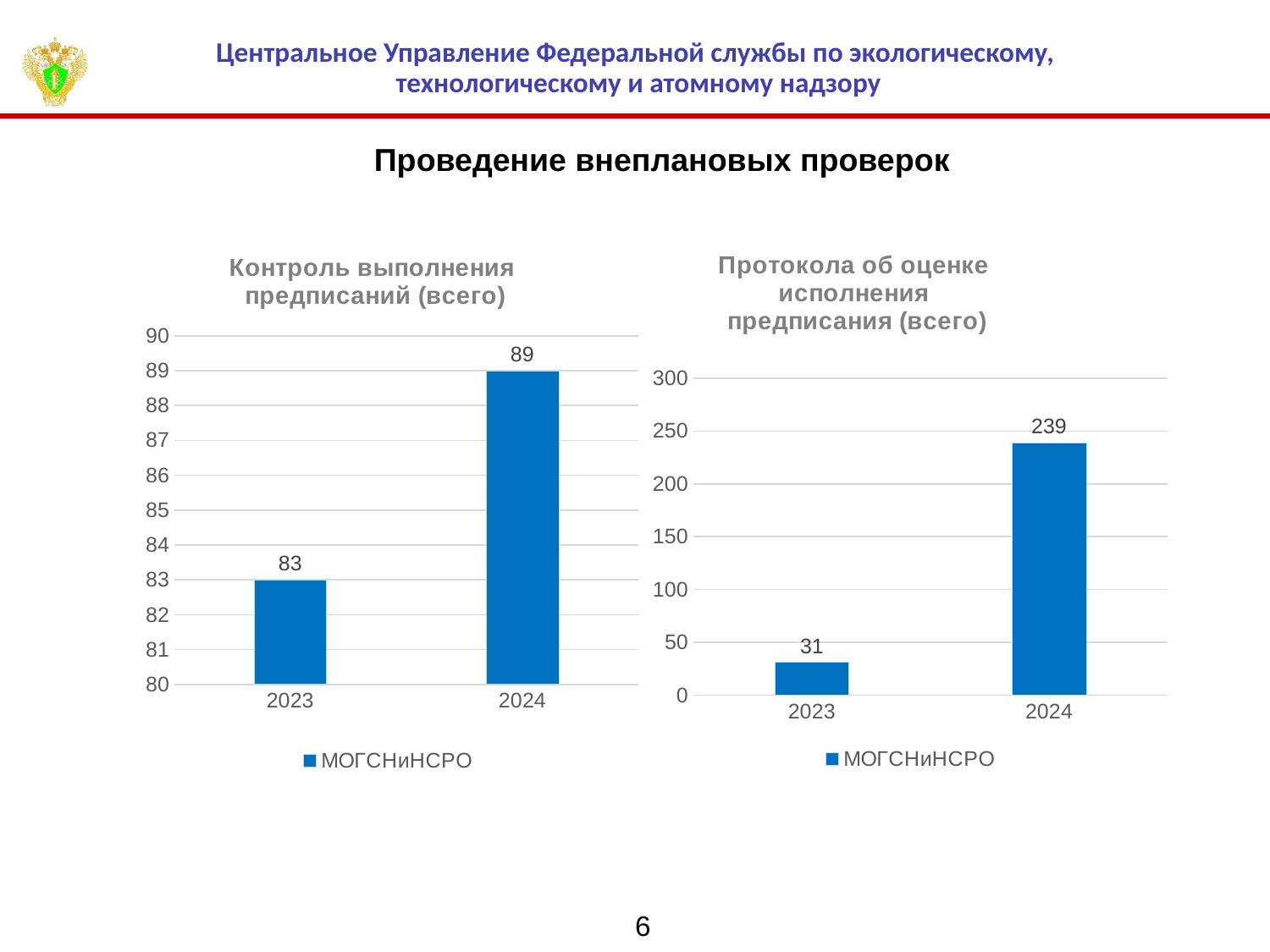
In the right chart 'Протокола об оценке исполнения предписания (всего)', what is the difference between the 2024 and 2023 values? 208 What type of chart is the right chart 'Протокола об оценке исполнения предписания (всего)'? bar chart In the right chart 'Протокола об оценке исполнения предписания (всего)', what is the value for 2024? 239 In the left chart 'Контроль выполнения предписаний (всего)', what is the value for 2024? 89 In the left chart 'Контроль выполнения предписаний (всего)', which year has the lower value? 2023 In the right chart 'Протокола об оценке исполнения предписания (всего)', is the value for 2024 greater or less than 200? greater What series name does the legend of the left chart 'Контроль выполнения предписаний (всего)' show? МОГСНиНСРО In the right chart 'Протокола об оценке исполнения предписания (всего)', which year has the higher value? 2024 In the left chart 'Контроль выполнения предписаний (всего)', what is the difference between the 2024 and 2023 values? 6 How many categories are shown on the x axis of the left chart 'Контроль выполнения предписаний (всего)'? 2 In the left chart 'Контроль выполнения предписаний (всего)', what is the value for 2023? 83 In the right chart 'Протокола об оценке исполнения предписания (всего)', what is the value for 2023? 31